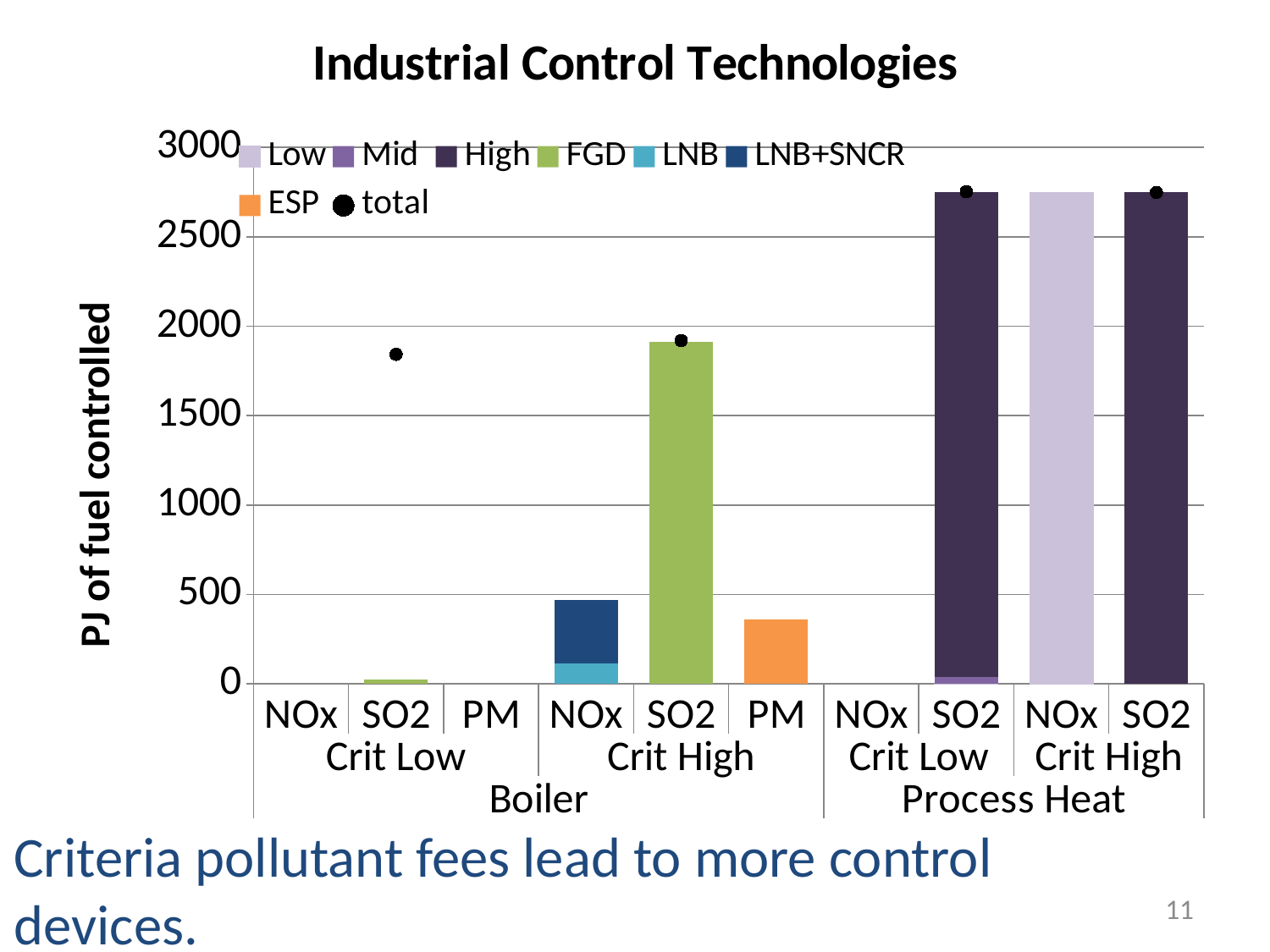
Which is larger, the bar for PM under Boiler Crit High or the bar for SO2 under Boiler Crit Low? PM under Boiler Crit High Within the Boiler group, which category has the tallest bar? Crit High SO2 Is the value for PM under Boiler Crit High greater or less than 500? less What is the title of the chart? Industrial Control Technologies Is the value for SO2 under Boiler Crit High greater or less than 1500? greater How many pollutant categories are plotted along the x axis? 10 How many entries does the chart legend list? 8 Which is larger, the bar for SO2 or the bar for NOx under Boiler Crit High? SO2 What kind of chart is shown on the slide? bar chart Is the value for SO2 under Process Heat Crit High greater or less than 3000? less What is the label on the y axis? PJ of fuel controlled